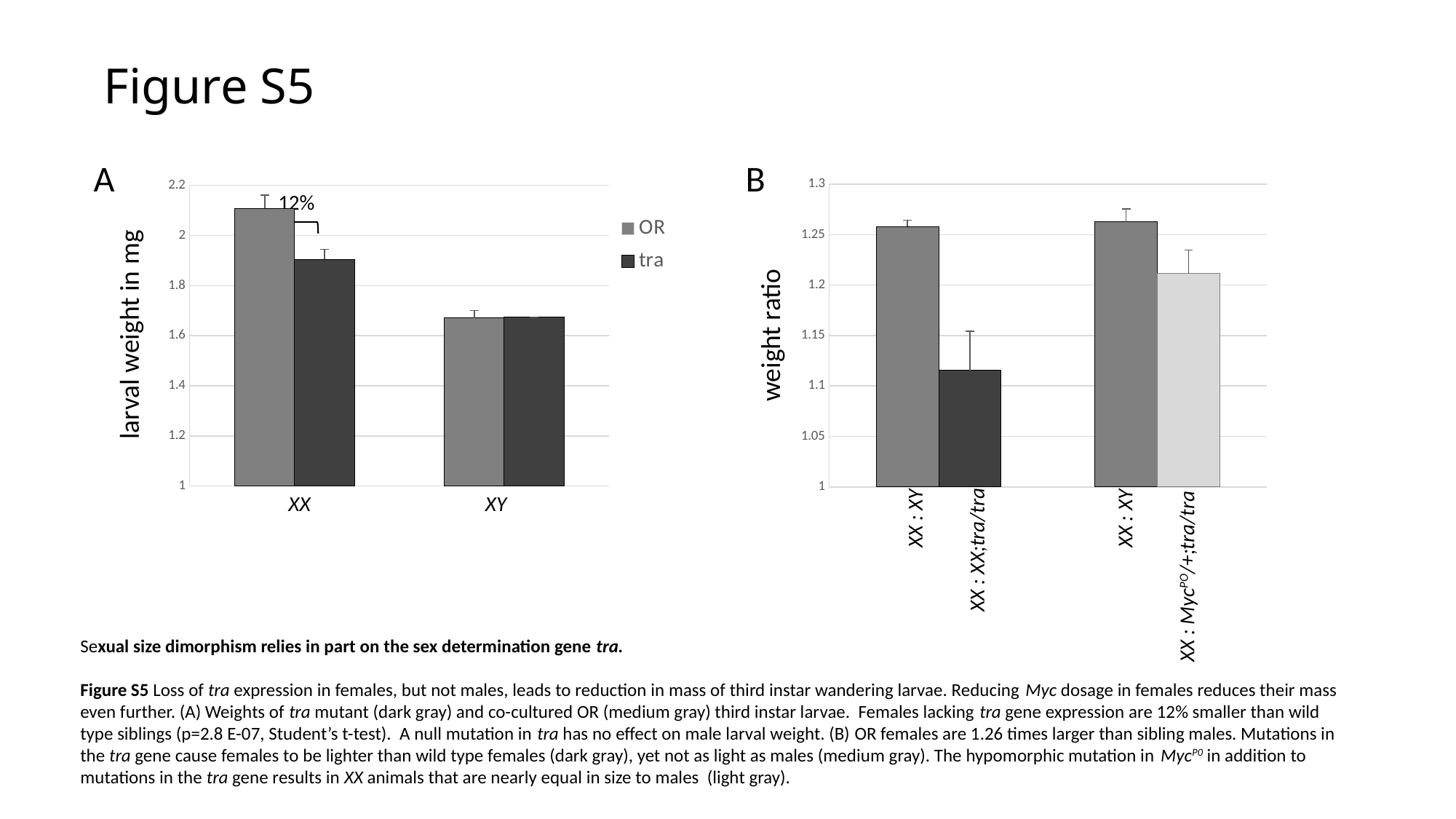
In chart B (weight ratio), which category has the lowest bar? XX : XX;tra/tra In chart B (weight ratio), is the value for XX : XX;tra/tra greater or less than 1.15? less In chart A (larval weight in mg), is the tra value for XX greater or less than 2? less In chart A (larval weight in mg), what percentage difference is annotated between the XX bars? 12% What are the two legend entries in chart A (larval weight in mg)? OR and tra What kind of chart is chart A (larval weight in mg)? bar chart How many bars are plotted in chart B (weight ratio)? 4 In chart A (larval weight in mg), is the OR value for XX greater or less than 2? greater In chart A (larval weight in mg), which category has the higher OR bar, XX or XY? XX How many series does the legend of chart A (larval weight in mg) list? 2